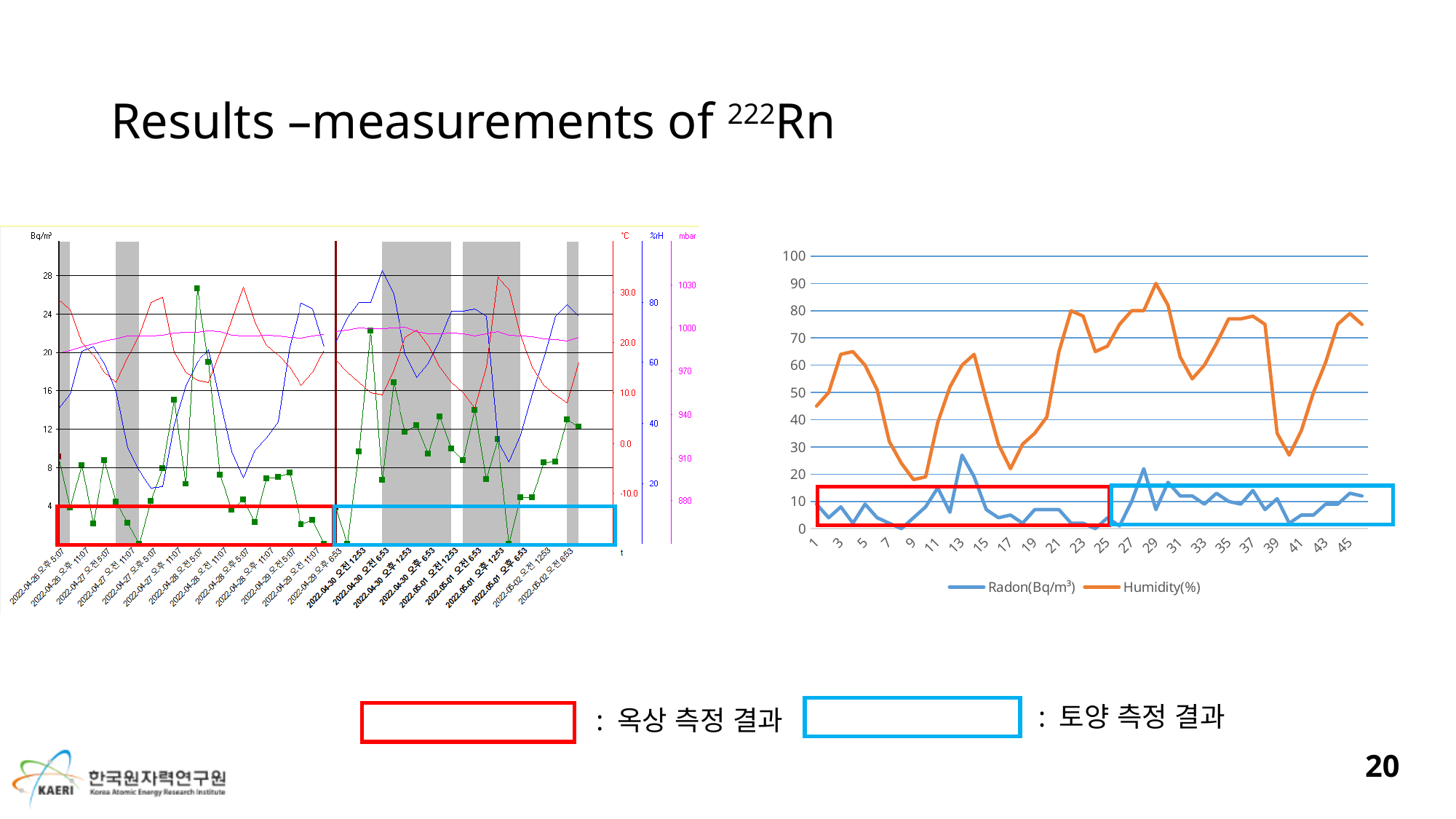
What kind of chart is the chart on the right of the slide? line chart In the right-hand chart, which series is drawn in blue? Radon(Bq/m³) In the right-hand chart, which series is drawn in orange? Humidity(%) In the right-hand chart, at which x-axis point does Humidity(%) reach its highest value? 29 In the right-hand chart, is the Humidity(%) value at point 17 greater or less than 30? less How many series does the legend of the right-hand chart list? 2 In the right-hand chart, at which x-axis point does Radon(Bq/m³) reach its highest value? 13 In the right-hand chart, which is larger at point 29: the Humidity(%) value or the Radon(Bq/m³) value? Humidity(%) In the right-hand chart, is the Humidity(%) value at point 29 greater or less than 80? greater In the right-hand chart, which is larger: the Humidity(%) value at point 9 or at point 29? point 29 In the right-hand chart, is the Radon(Bq/m³) value at point 13 greater or less than 20? greater